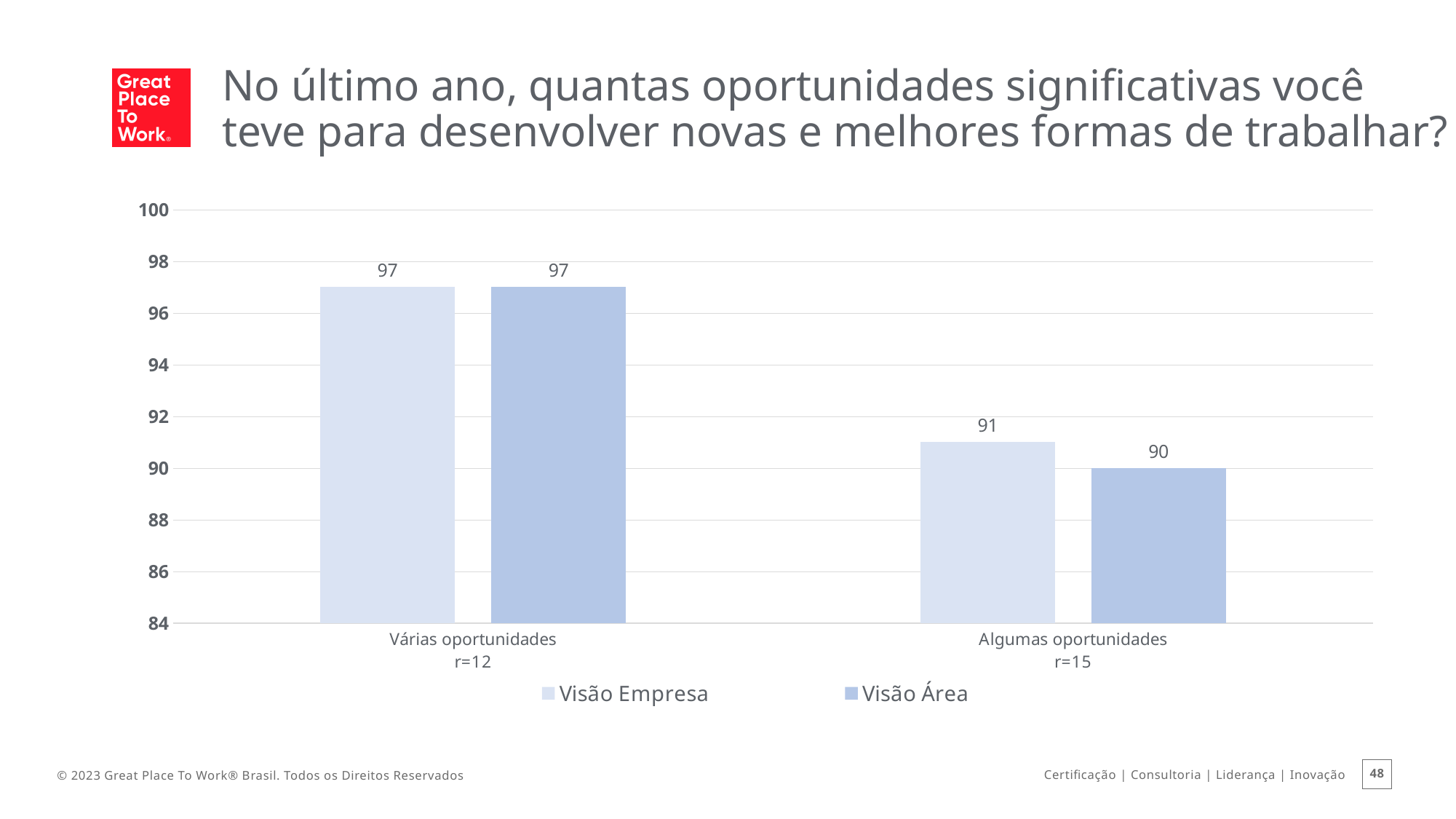
How many series does the legend list? 2 What is the difference between the Visão Empresa values for Várias oportunidades and Algumas oportunidades? 6 Is the Visão Área value for Várias oportunidades greater or less than 94? greater What is the Visão Empresa value for Algumas oportunidades? 91 What is the Visão Empresa value for Várias oportunidades? 97 What kind of chart is shown on the slide? bar chart What is the Visão Área value for Algumas oportunidades? 90 What is the difference between the Visão Empresa and Visão Área values for Algumas oportunidades? 1 How many categories are shown on the x axis? 2 Which is larger: the Visão Empresa value for Algumas oportunidades or the Visão Área value for Algumas oportunidades? Visão Empresa Which category has the highest Visão Empresa value? Várias oportunidades Which category has the lowest Visão Área value? Algumas oportunidades